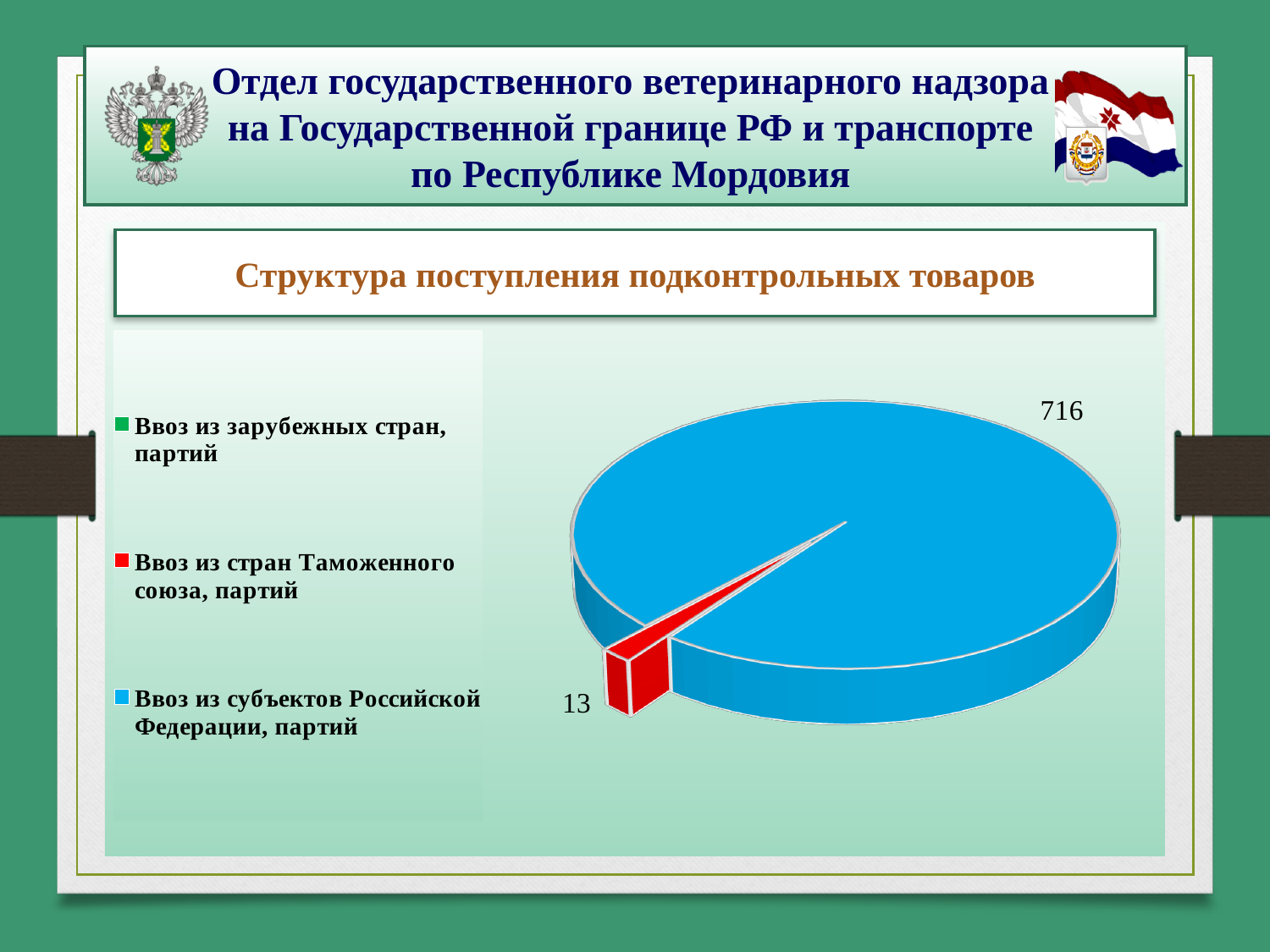
Which category has the largest slice of the pie? Ввоз из субъектов Российской Федерации, партий What is the difference between the value for Ввоз из субъектов Российской Федерации, партий and the value for Ввоз из стран Таможенного союза, партий? 703 What kind of chart is shown on the slide? Pie chart What is the value for Ввоз из субъектов Российской Федерации, партий? 716 What is the title of the chart? Структура поступления подконтрольных товаров What colour is the slice for Ввоз из стран Таможенного союза, партий? Red What is the value for Ввоз из стран Таможенного союза, партий? 13 Which is larger: the value for Ввоз из стран Таможенного союза, партий or the value for Ввоз из субъектов Российской Федерации, партий? Ввоз из субъектов Российской Федерации, партий How many entries does the legend list? 3